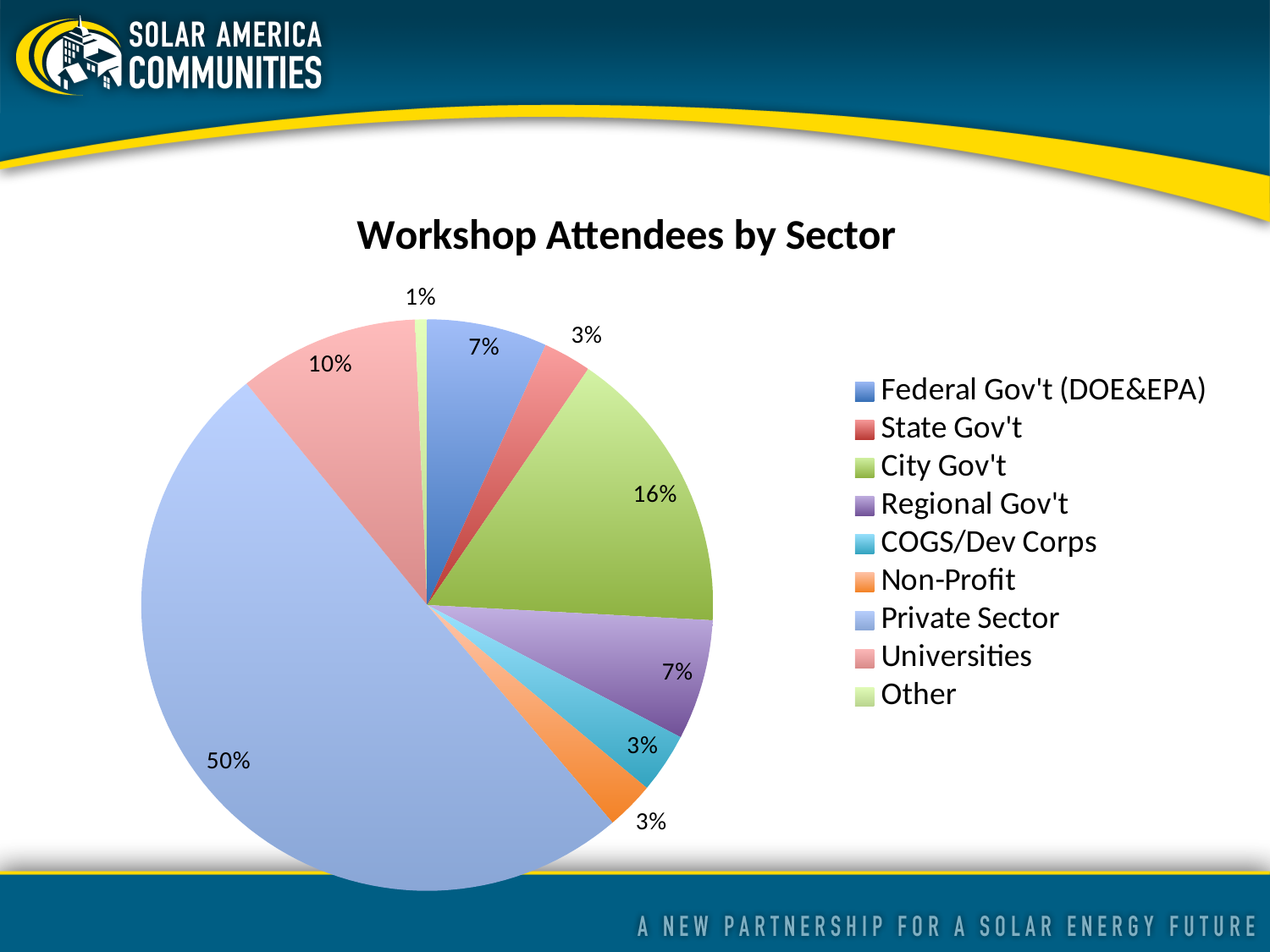
What share of workshop attendees came from Federal Gov't (DOE&EPA)? 7% What is the difference in percentage points between the Private Sector share and the City Gov't share? 34 What share of workshop attendees came from Universities? 10% What is the title of the chart? Workshop Attendees by Sector What share of workshop attendees is labelled Other? 1% Which has a larger share of attendees, Universities or Regional Gov't? Universities What type of chart is shown on the slide? Pie chart How many sectors does the legend list? 9 Which sector has the smallest share of workshop attendees? Other Which sector has the largest share of workshop attendees? Private Sector